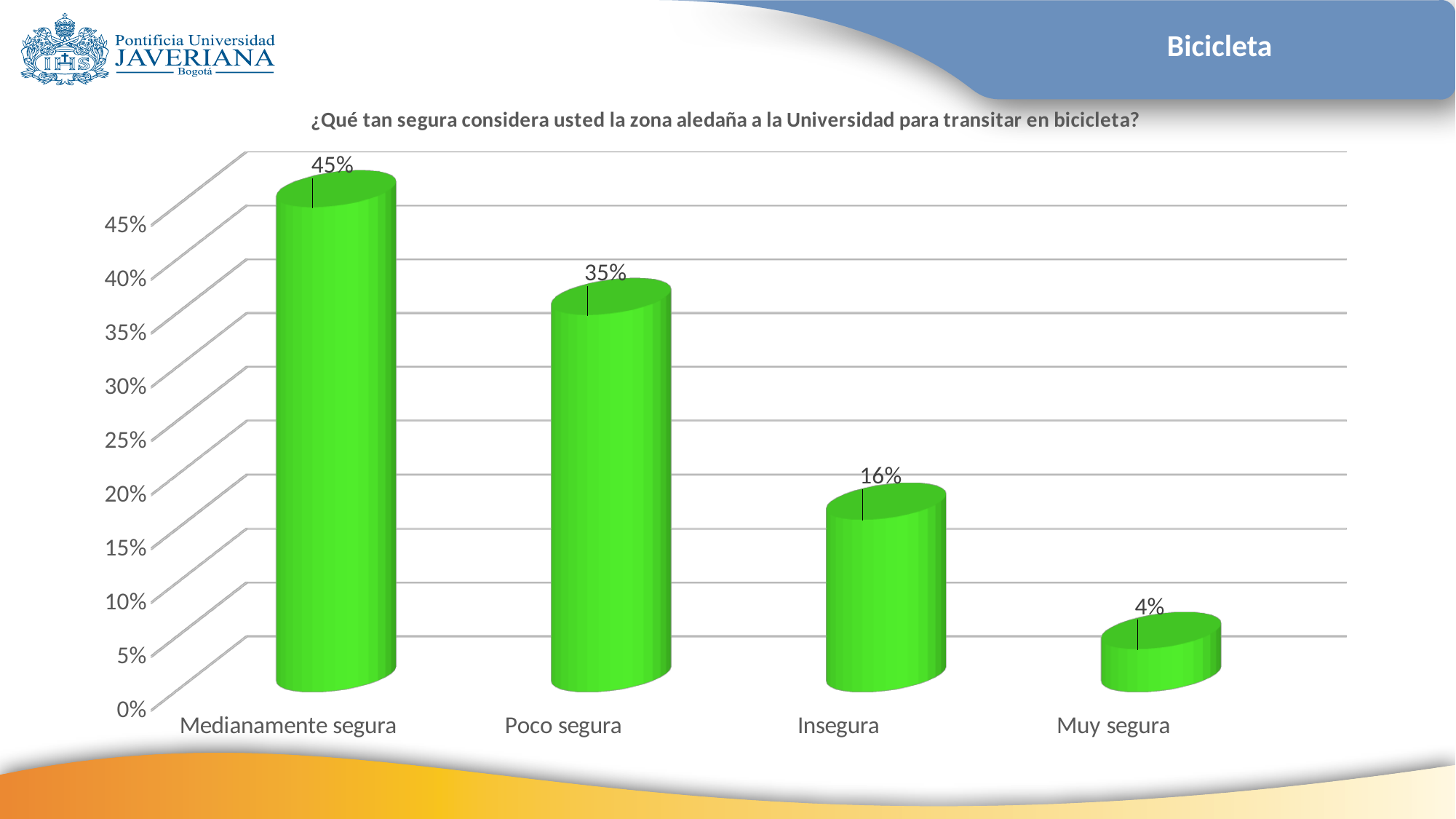
Which is larger, the value for Poco segura or the value for Insegura? Poco segura What is the value for Medianamente segura? 45% Which category has the highest value? Medianamente segura What is the value for Poco segura? 35% Do the values rise or fall from left to right along the x axis? Fall What is the value for Insegura? 16% How many categories are shown on the chart? 4 Which category has the lowest value? Muy segura What is the difference between the values for Medianamente segura and Poco segura? 10% What kind of chart is shown on the slide? Bar chart What is the value for Muy segura? 4% What is the difference between the values for Insegura and Muy segura? 12%